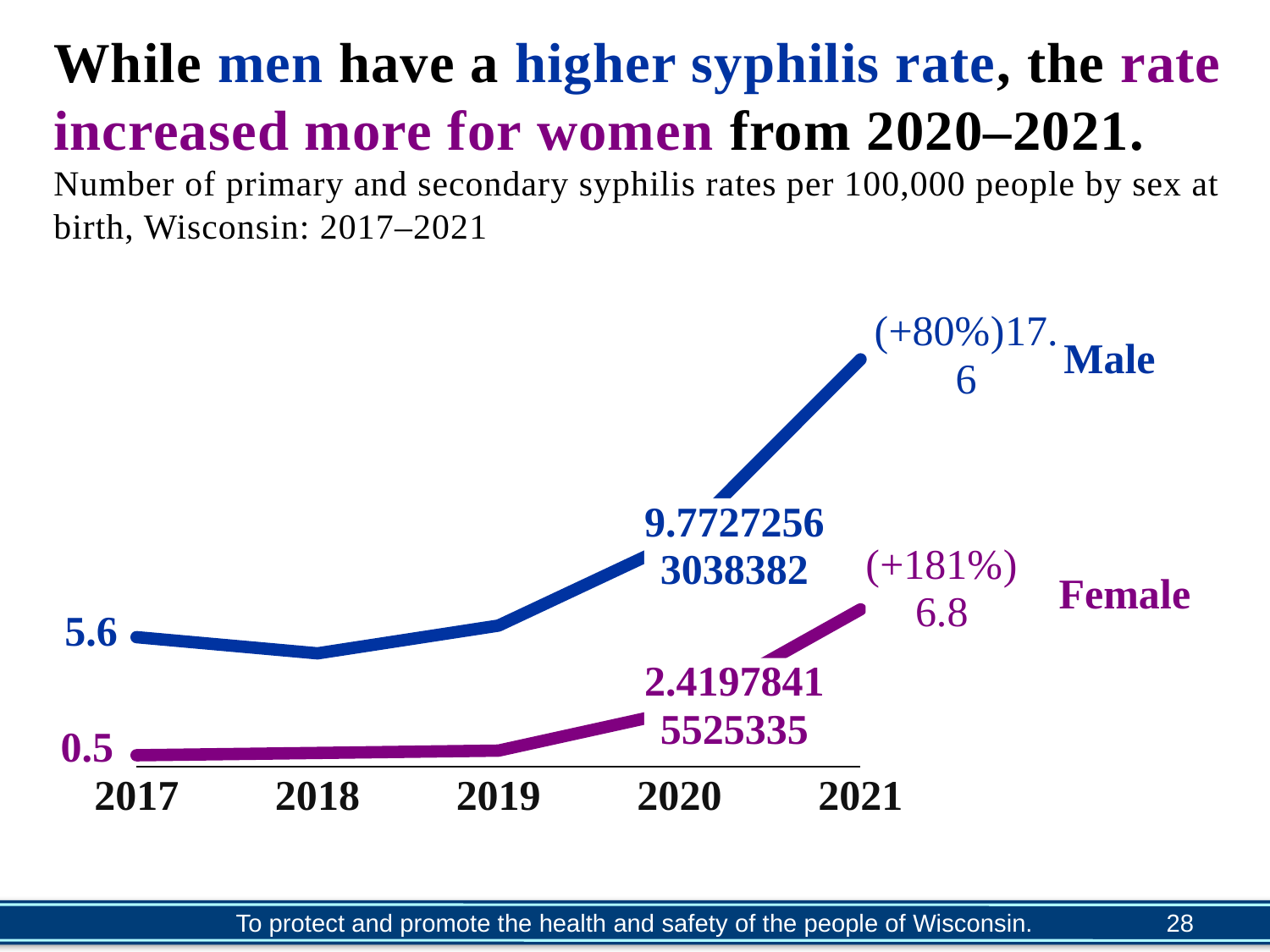
What is the syphilis rate for females in 2021? 6.8 Which series has the higher rate in 2021, Male or Female? Male What percentage increase is shown for the male rate from 2020 to 2021? +80% What is the difference between the male and female syphilis rates in 2021? 10.8 How many series are plotted on the chart? 2 What percentage increase is shown for the female rate from 2020 to 2021? +181% What is the syphilis rate for males in 2017? 5.6 What is the syphilis rate for females in 2017? 0.5 How many years are shown on the x axis? 5 By how much did the male syphilis rate increase from 2017 to 2021? 12.0 What type of chart is shown on the slide? Line chart What is the syphilis rate for males in 2021? 17.6